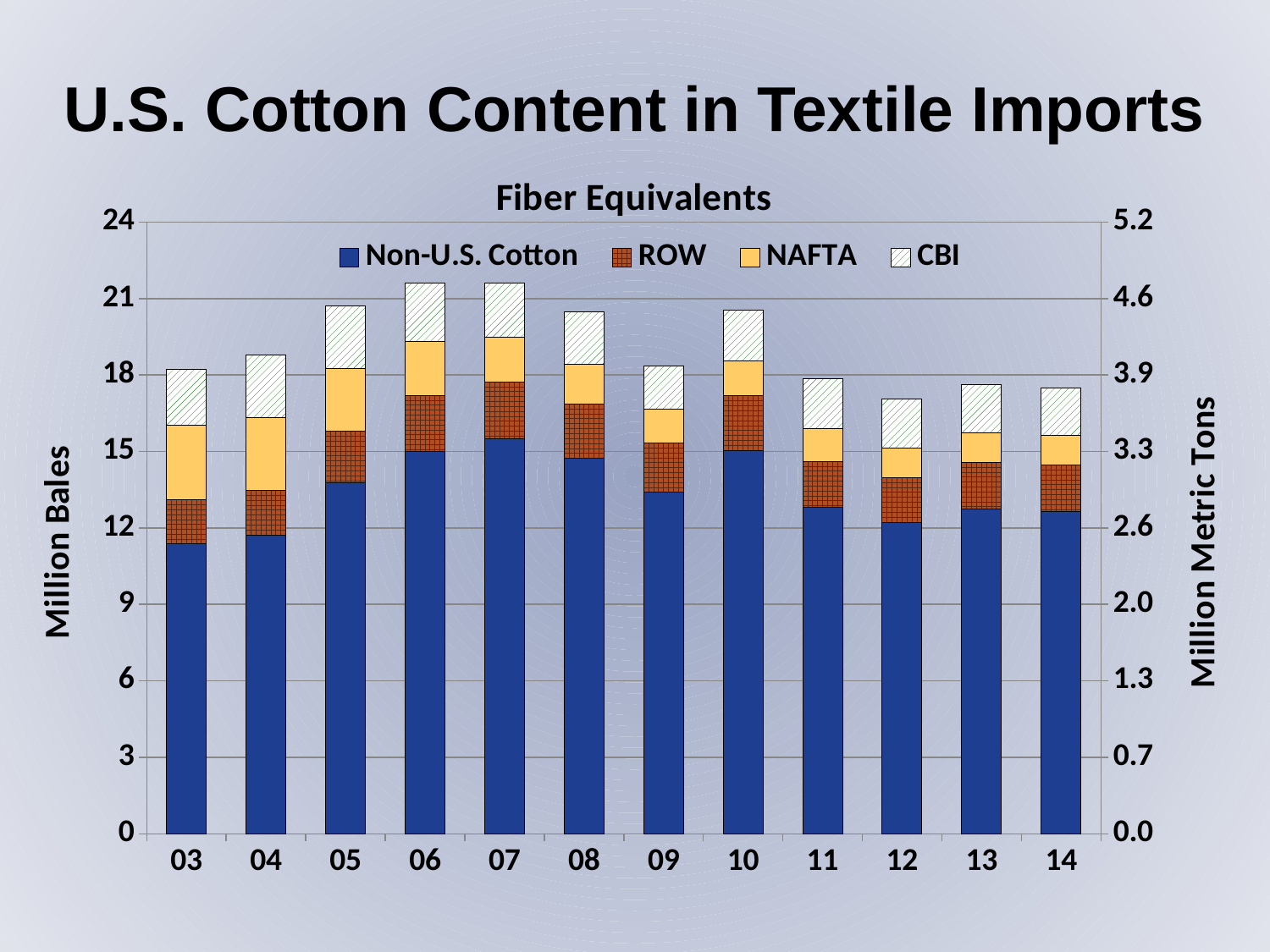
Is the Non-U.S. Cotton value for 03 greater or less than 12 million bales? less How many series does the chart's legend list? 4 Do the total stacked values rise or fall from 10 to 12? fall What is the label of the left vertical axis? Million Bales Do the total stacked values rise or fall from 03 to 06? rise Which year has the larger Non-U.S. Cotton value, 07 or 12? 07 Is the total stacked value for 12 greater or less than 18 million bales? less Is the total stacked value for 06 greater or less than 21 million bales? greater What kind of chart is shown on the slide? Stacked bar chart How many years are shown along the x axis of the chart? 12 Which year has the larger total stacked bar, 05 or 11? 05 Which series are listed in the chart's legend? Non-U.S. Cotton, ROW, NAFTA, CBI